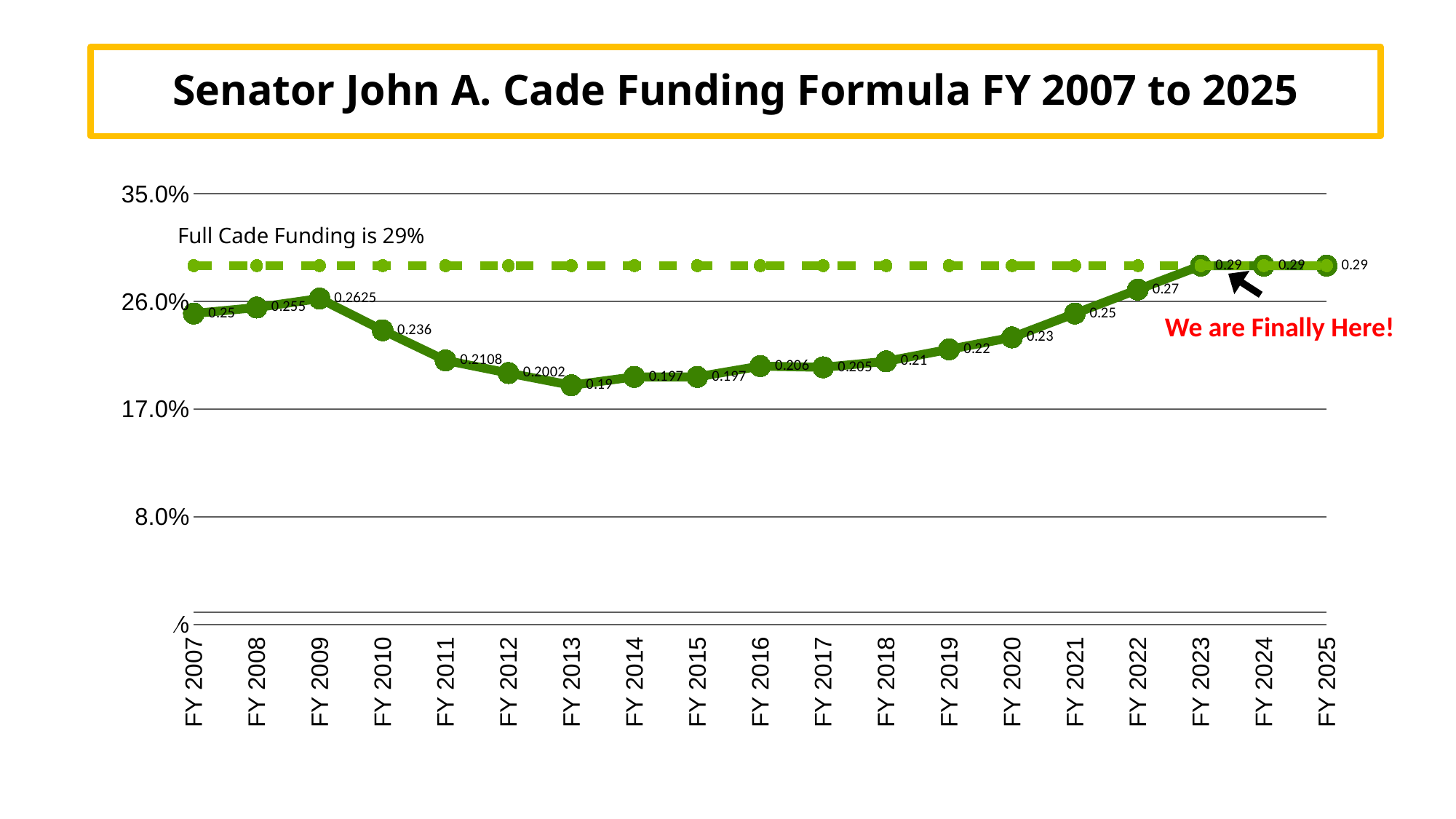
What is the difference between the values for FY 2009 and FY 2013? 0.0725 What is the value for FY 2022? 0.27 What is the value for FY 2009? 0.2625 What level does the dashed horizontal line represent, according to its label? Full Cade Funding is 29% What type of chart is shown on the slide? line chart How many fiscal years are plotted on the x axis? 19 Which fiscal year has the lowest value? FY 2013 Do the values rise or fall from FY 2013 to FY 2023? rise What is the value for FY 2013? 0.19 Is the value for FY 2013 greater or less than 26.0%? less What is the highest value plotted on the line? 0.29 Which is larger, the value for FY 2011 or the value for FY 2019? FY 2019